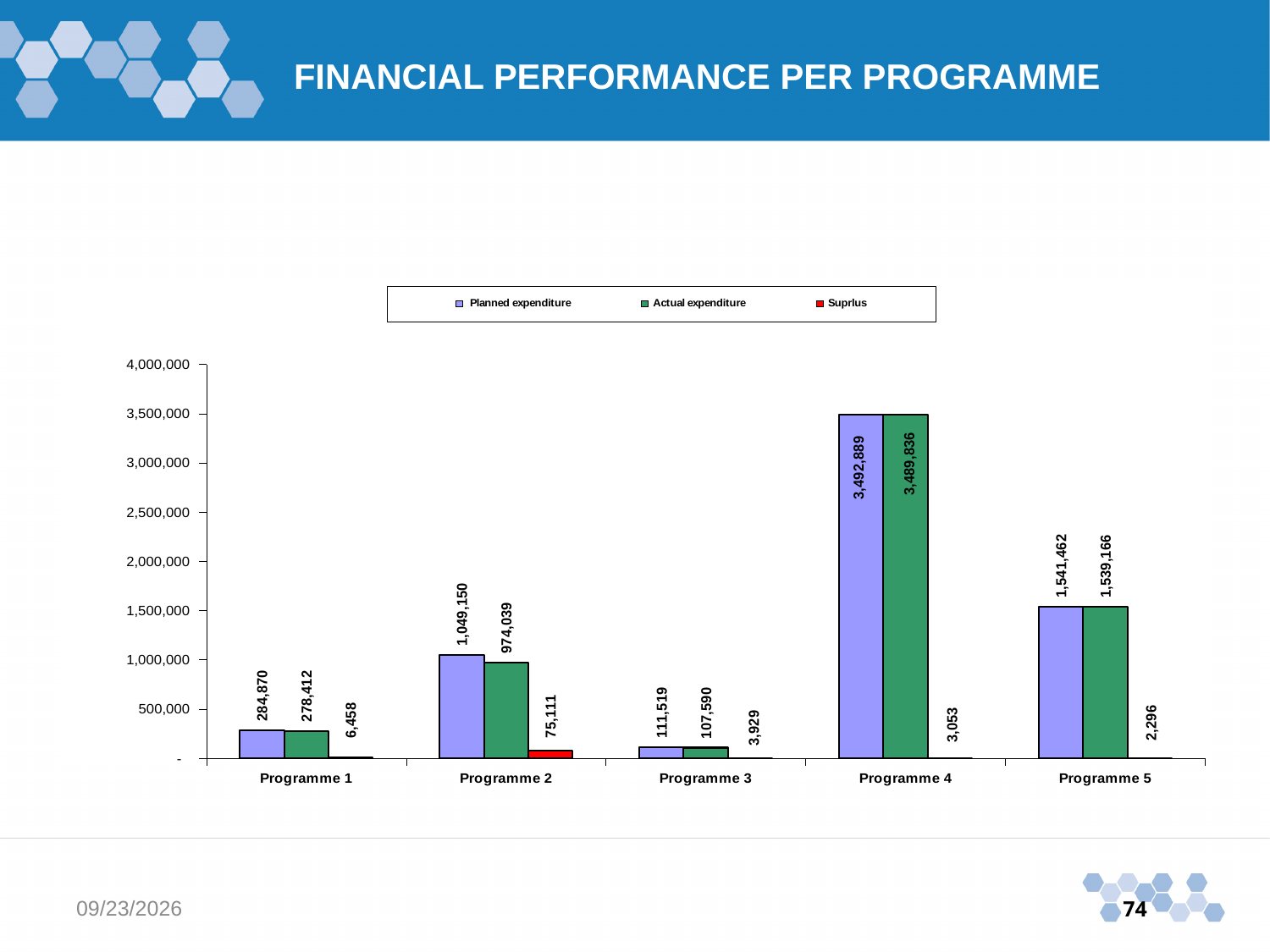
How many programmes are shown on the x axis? 5 What is the surplus for Programme 1? 6,458 Which programme has the lowest actual expenditure? Programme 3 Is the planned expenditure for Programme 2 larger than the planned expenditure for Programme 5? No Which programme has the highest planned expenditure? Programme 4 What type of chart is shown on the slide? Bar chart What is the actual expenditure for Programme 3? 107,590 What is the difference between planned and actual expenditure for Programme 5? 2,296 What is the planned expenditure for Programme 2? 1,049,150 What is the actual expenditure for Programme 4? 3,489,836 Which programme has the largest surplus? Programme 2 How many series does the legend list? 3